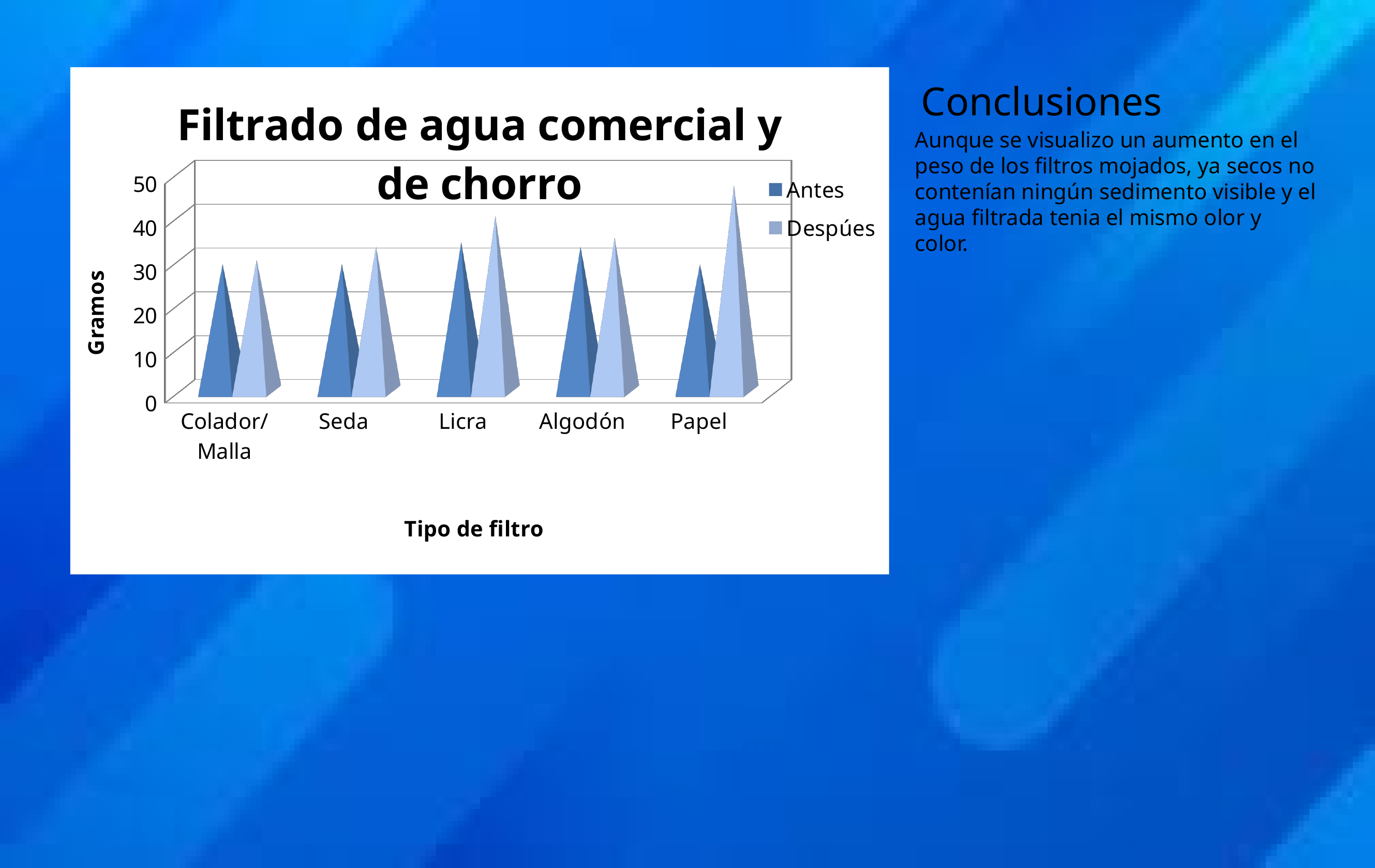
Is the Antes value for Licra greater or less than 30? greater For Papel, which is larger, the Antes value or the Despúes value? Despúes What is the title of the chart? Filtrado de agua comercial y de chorro How many filter types are shown on the x axis of the chart? 5 How many series does the chart legend list? 2 Is the Antes value for Colador/Malla greater or less than 40? less Which is larger, the Antes value for Licra or the Antes value for Seda? Licra Is the Antes value for Papel greater or less than 40? less What are the two series named in the chart legend? Antes and Despúes Which filter type has the highest Despúes value? Papel What kind of chart is shown on the slide? bar chart